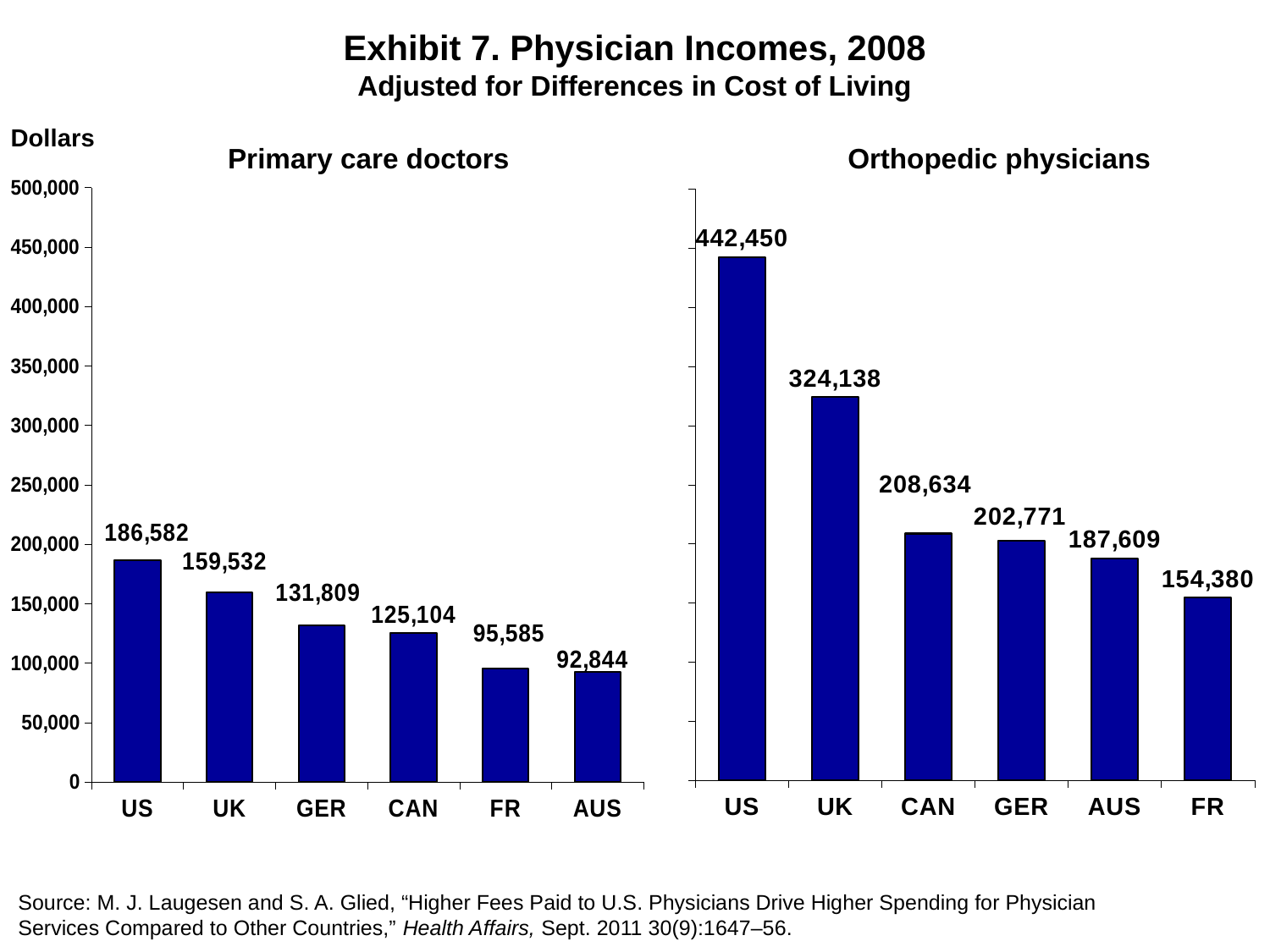
In the Primary care doctors chart, what is the difference between the UK and CAN values? 34,428 What kind of chart is the Orthopedic physicians chart? bar chart In the Primary care doctors chart, what is the value for the US? 186,582 What is the main title of the slide? Exhibit 7. Physician Incomes, 2008 In the Orthopedic physicians chart, what is the value for GER? 202,771 In the Orthopedic physicians chart, do the values rise or fall from left to right along the x axis? fall In the Orthopedic physicians chart, what is the difference between the US and UK values? 118,312 In the Primary care doctors chart, which country has the lowest value? AUS In the Orthopedic physicians chart, which country has the highest value? US In the Primary care doctors chart, which is larger, the value for GER or the value for FR? GER In the Orthopedic physicians chart, is the value for CAN greater or less than 250,000? less How many countries are shown in the Primary care doctors chart? 6